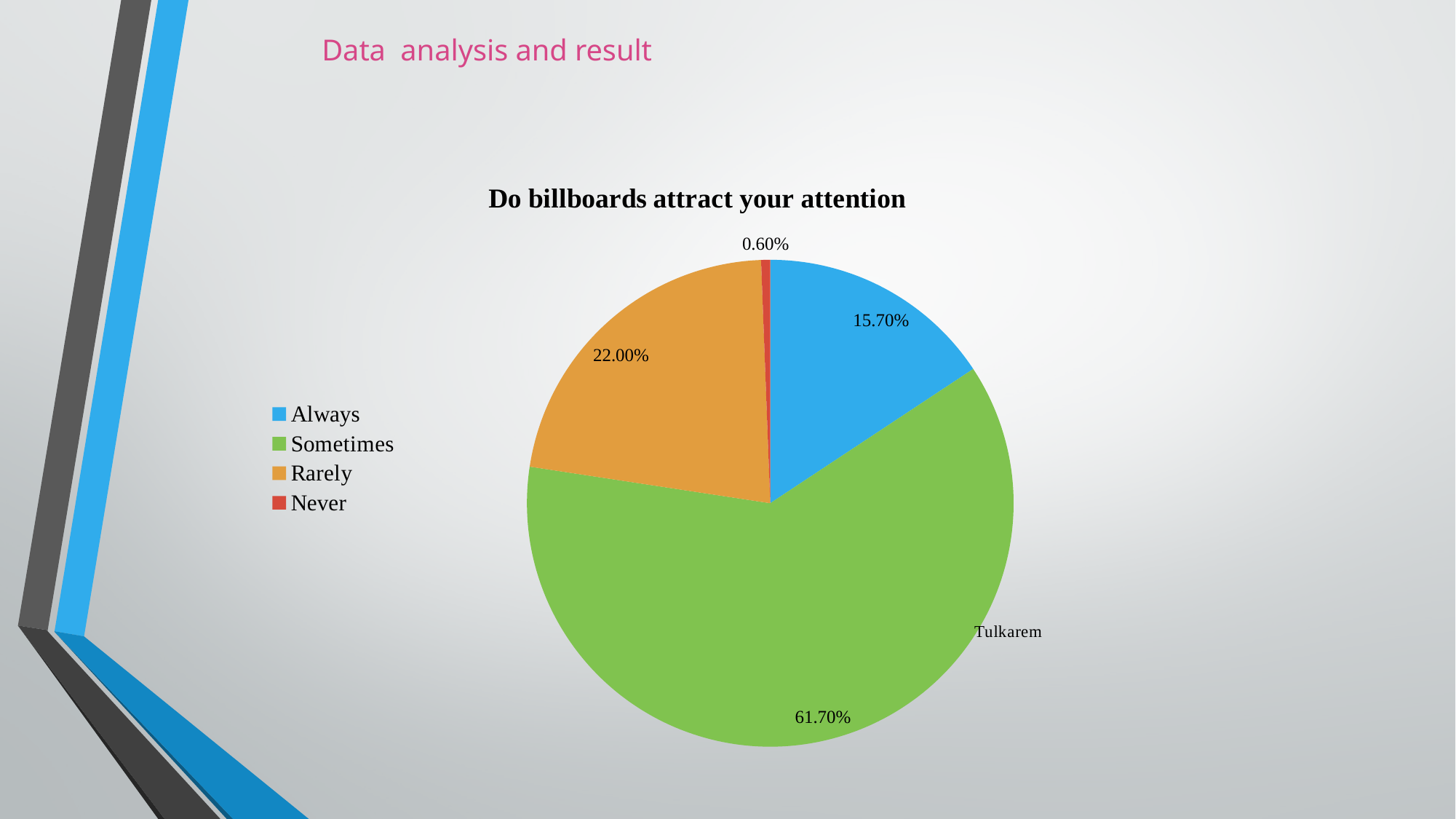
What percentage of respondents answered Always? 15.70% What is the title of the chart? Do billboards attract your attention What type of chart is shown on the slide? pie chart Which response has the smallest share of the pie? Never How many categories does the legend list? 4 What colour is the Rarely slice? orange What percentage of respondents answered Rarely? 22.00% What percentage of respondents answered Sometimes? 61.70% What percentage of respondents answered Never? 0.60% Which is larger, the share for Rarely or the share for Always? Rarely What is the difference in percentage points between Sometimes and Rarely? 39.70% Which response has the largest share of the pie? Sometimes